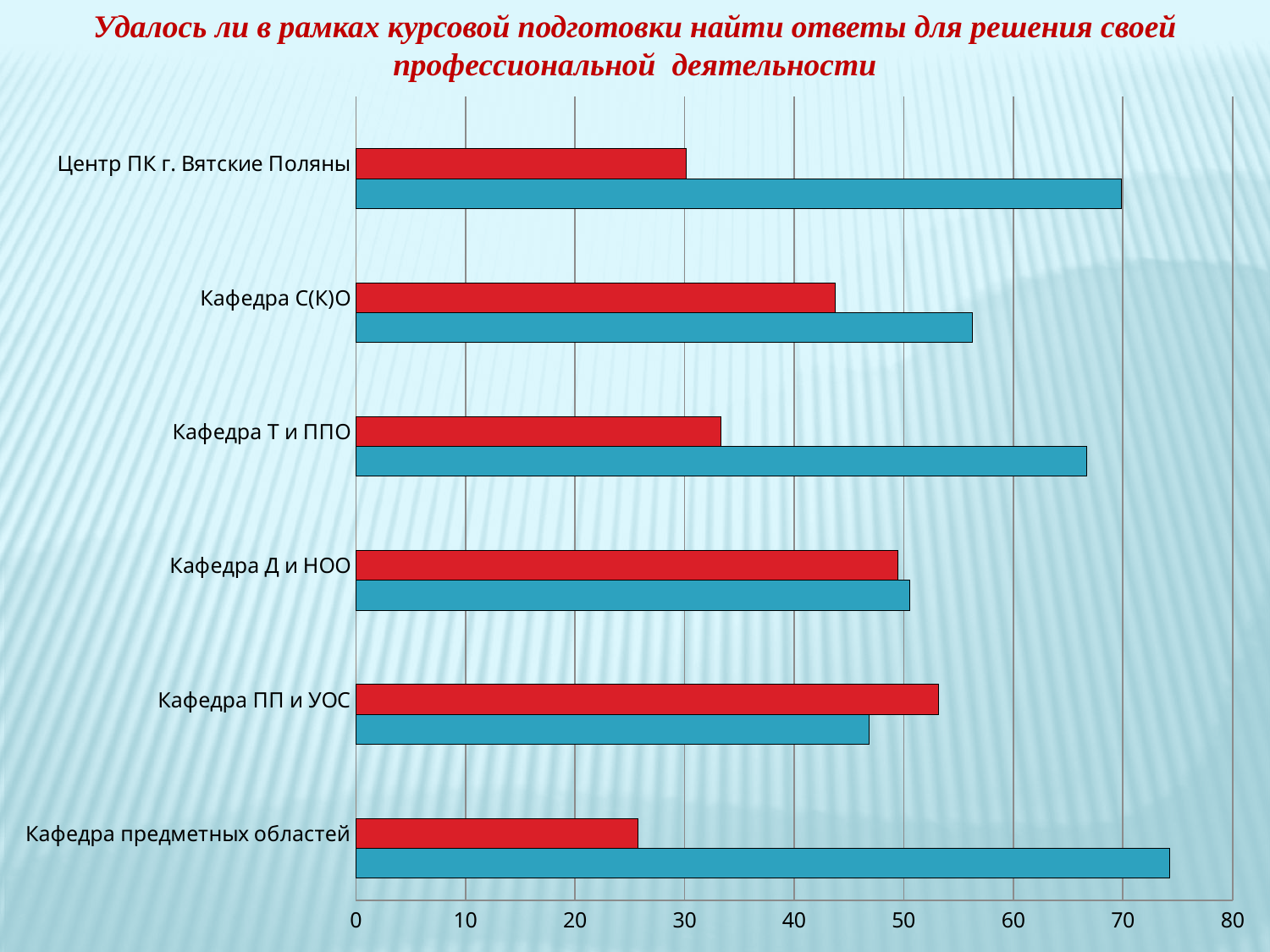
Which category has the longest red bar? Кафедра ПП и УОС Which category has the longest blue bar? Кафедра предметных областей Which category has the shortest blue bar? Кафедра ПП и УОС What kind of chart is shown on the slide? bar chart Is the red bar for Кафедра ПП и УОС greater or less than 50? greater How many categories are shown on the vertical axis of the chart? 6 For Центр ПК г. Вятские Поляны, which bar is longer, the red one or the blue one? the blue one Which category has the shortest red bar? Кафедра предметных областей How many bars are shown for each category in the chart? 2 What is the maximum value shown on the horizontal axis of the chart? 80 Is the blue bar for Кафедра предметных областей greater or less than 70? greater Is the red bar for Кафедра предметных областей greater or less than 30? less